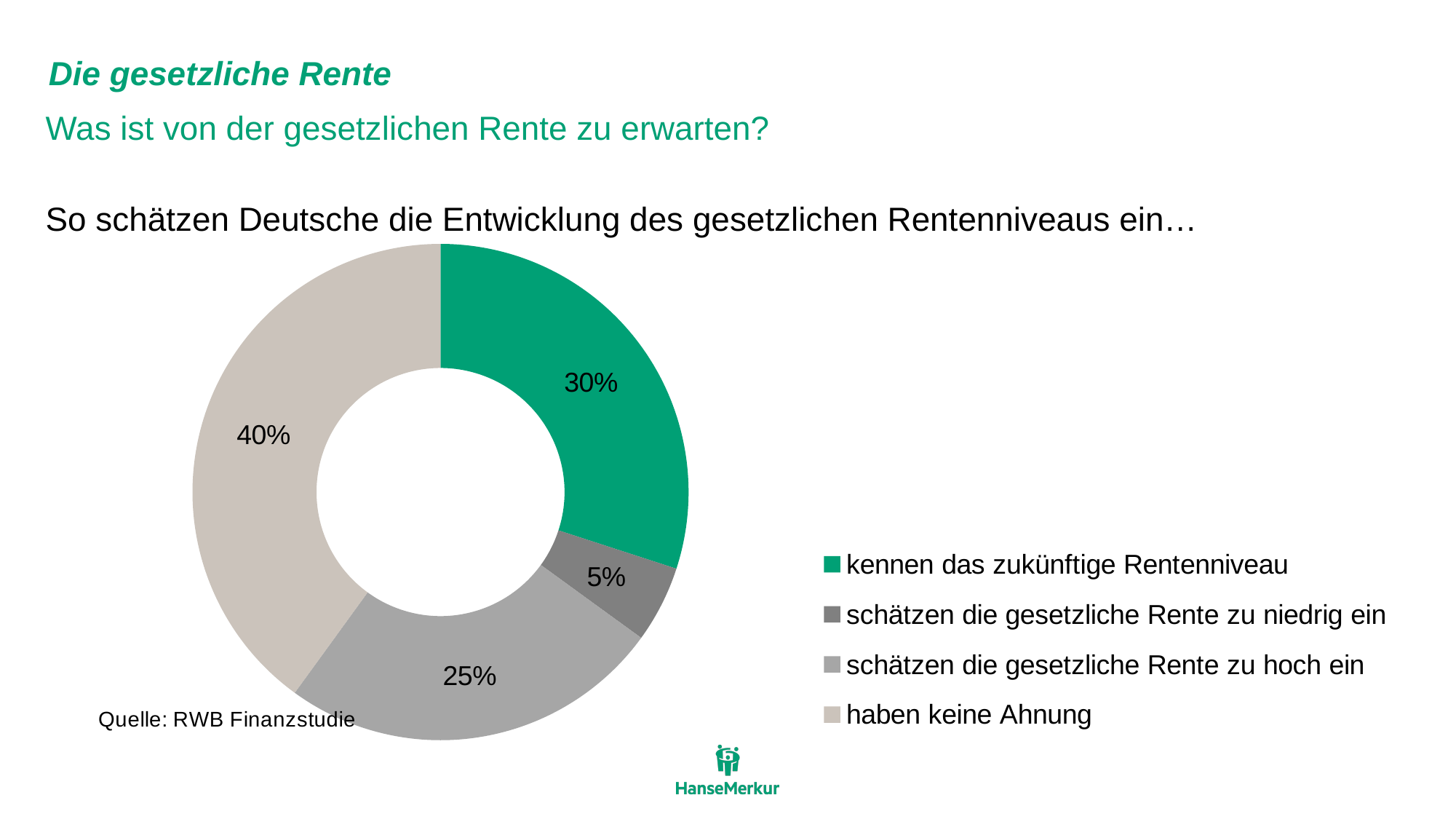
What is the combined share of the two categories that misjudge the pension (zu niedrig and zu hoch)? 30% How many categories does the chart show? 4 What percentage of respondents 'schätzen die gesetzliche Rente zu niedrig ein'? 5% What kind of chart is shown on the slide? Doughnut (pie) chart Which colour represents 'kennen das zukünftige Rentenniveau' in the chart? Green Which category has the smallest share of the chart? schätzen die gesetzliche Rente zu niedrig ein What is the difference in percentage points between 'haben keine Ahnung' and 'kennen das zukünftige Rentenniveau'? 10 percentage points What percentage of respondents 'kennen das zukünftige Rentenniveau'? 30% Which is larger: the share for 'schätzen die gesetzliche Rente zu hoch ein' or for 'schätzen die gesetzliche Rente zu niedrig ein'? schätzen die gesetzliche Rente zu hoch ein Which category has the largest share of the chart? haben keine Ahnung What percentage of respondents 'haben keine Ahnung'? 40% What percentage of respondents 'schätzen die gesetzliche Rente zu hoch ein'? 25%